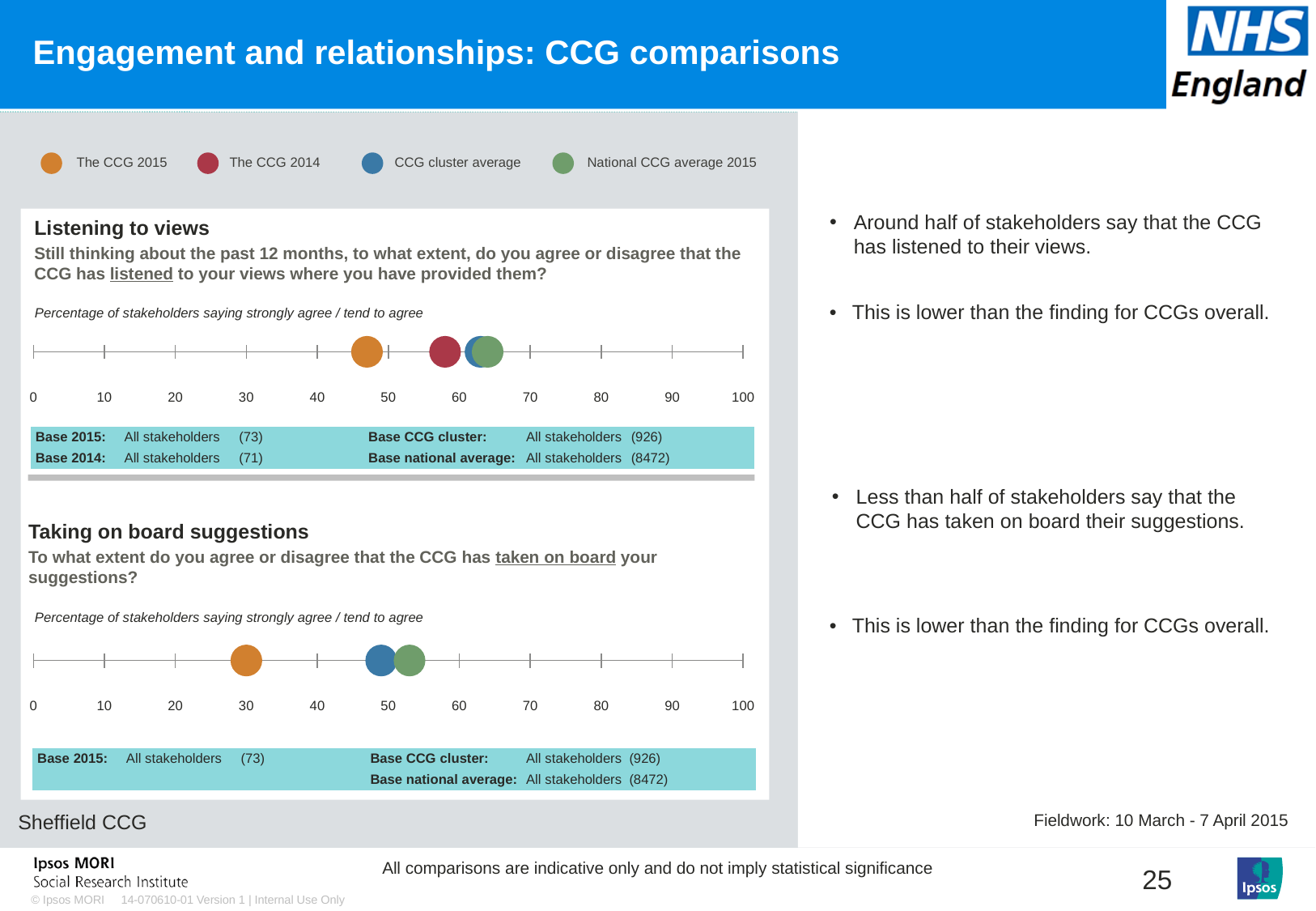
In the 'Listening to views' chart, is the value for The CCG 2015 greater or less than 50? less In the 'Listening to views' chart, which series has the lowest value? The CCG 2015 How many series does the legend at the top of the slide list? 4 In the 'Listening to views' chart, is the value for National CCG average 2015 greater or less than 60? greater In the 'Listening to views' chart, which is larger, The CCG 2015 or The CCG 2014? The CCG 2014 What colour is the marker for The CCG 2015 in the legend? Orange In the 'Taking on board suggestions' chart, which is larger, The CCG 2015 or the National CCG average 2015? National CCG average 2015 In the 'Taking on board suggestions' chart, which series has the lowest value? The CCG 2015 In the 'Taking on board suggestions' chart, is the value for National CCG average 2015 greater or less than 40? greater How many data markers are plotted in the 'Taking on board suggestions' chart? 3